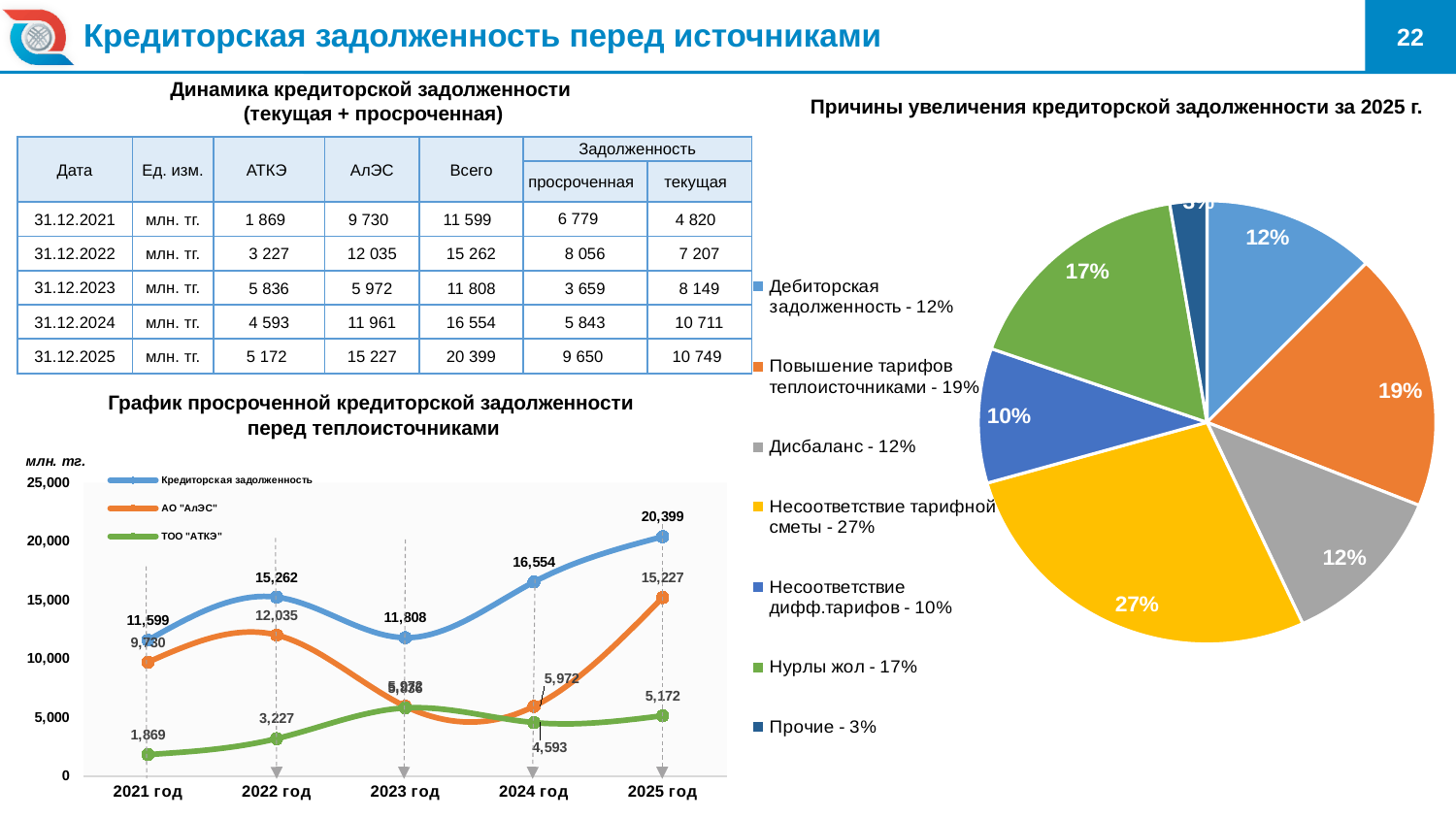
On the pie chart 'Причины увеличения кредиторской задолженности за 2025 г.', how many categories are listed in the legend? 7 On the line chart 'График просроченной кредиторской задолженности перед теплоисточниками', which is larger in 2025 год: АО "АлЭС" or ТОО "АТКЭ"? АО "АлЭС" On the line chart 'График просроченной кредиторской задолженности перед теплоисточниками', in which year is 'Кредиторская задолженность' the lowest? 2021 год On the line chart 'График просроченной кредиторской задолженности перед теплоисточниками', what is the value of АО "АлЭС" for 2021 год? 9,730 On the line chart 'График просроченной кредиторской задолженности перед теплоисточниками', what is the value of ТОО "АТКЭ" for 2022 год? 3,227 On the line chart 'График просроченной кредиторской задолженности перед теплоисточниками', how many series does the legend list? 3 On the line chart 'График просроченной кредиторской задолженности перед теплоисточниками', how many years are shown on the x axis? 5 On the pie chart 'Причины увеличения кредиторской задолженности за 2025 г.', which category has the smallest share? Прочие On the line chart 'График просроченной кредиторской задолженности перед теплоисточниками', what is the difference between 'Кредиторская задолженность' in 2025 год and 2024 год? 3,845 On the pie chart 'Причины увеличения кредиторской задолженности за 2025 г.', what share does 'Несоответствие тарифной сметы' have? 27% What type of chart is 'Причины увеличения кредиторской задолженности за 2025 г.'? Pie chart On the line chart 'График просроченной кредиторской задолженности перед теплоисточниками', what is the value of 'Кредиторская задолженность' for 2025 год? 20,399